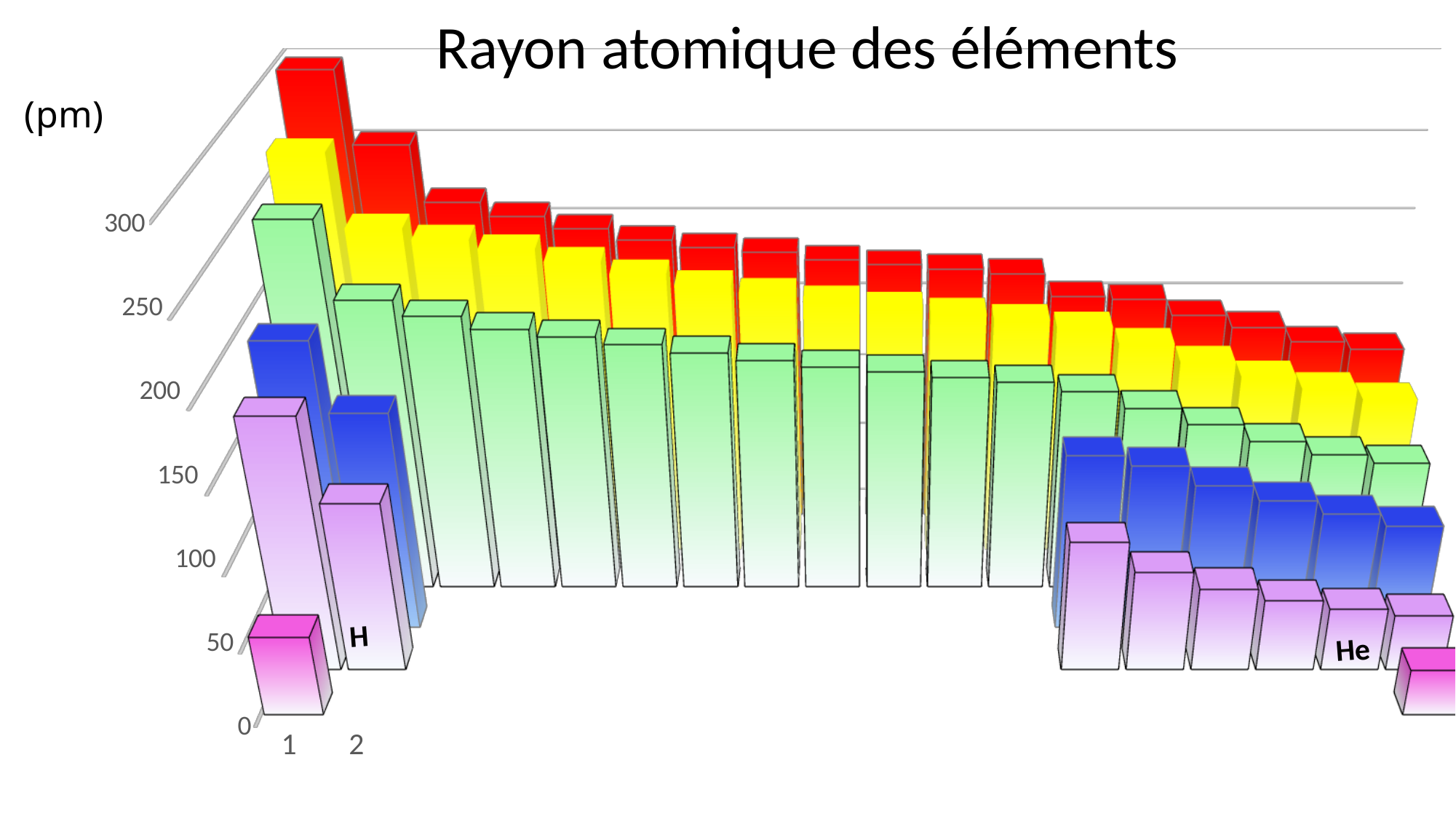
Is the tallest red bar greater or less than 250? greater Do the values in the red series rise or fall from left to right? fall Which coloured series contains the tallest bar in the chart? red What is the title of the chart? Rayon atomique des éléments Within the red series, which bar is the tallest? the leftmost (first) bar What is the highest tick value shown on the vertical axis? 300 How many differently coloured series (rows) of bars are plotted in the chart? 6 Which two element labels are printed on the front (pink) row of bars? H and He What type of chart is shown on the slide? bar chart Which is larger: the first red bar or the second red bar? the first red bar What unit is shown for the vertical axis of the chart? pm Do the values in the green series rise or fall from left to right? fall